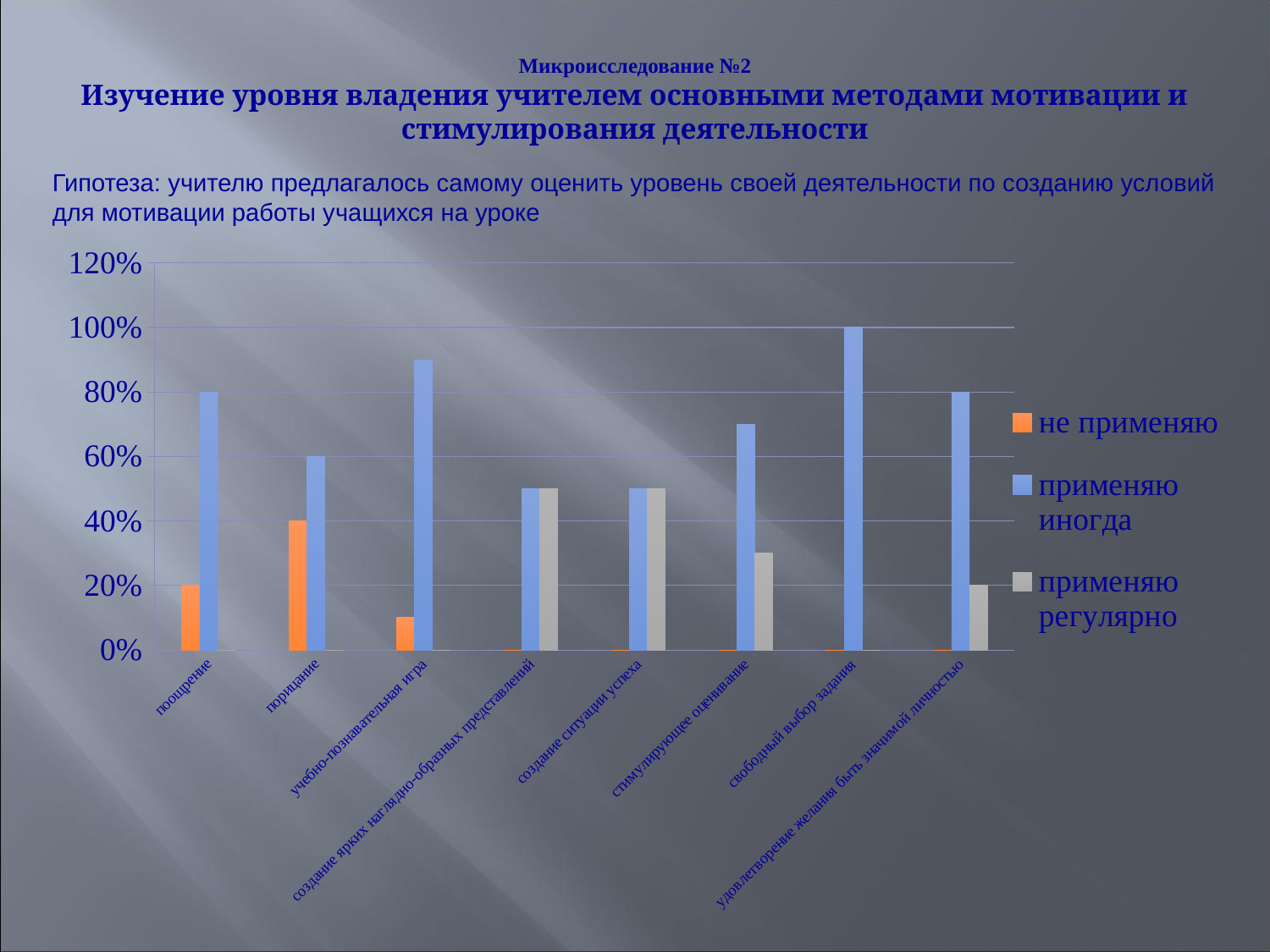
Which is larger for "порицание": "не применяю" or "применяю иногда"? применяю иногда Is the value of "применяю иногда" for "учебно-познавательная игра" greater or less than 80%? greater How many series does the legend list? 3 Is the value of "применяю регулярно" for "стимулирующее оценивание" greater or less than 40%? less What is the value of "применяю иногда" for "поощрение"? 80% What is the value of "применяю регулярно" for "удовлетворение желания быть значимой личностью"? 20% How many categories are shown on the x axis? 8 What is the value of "применяю иногда" for "свободный выбор задания"? 100% What is the value of "не применяю" for "порицание"? 40% Which category has the highest value for "применяю иногда"? свободный выбор задания Which category has the highest value for "не применяю"? порицание What kind of chart is shown on the slide? bar chart